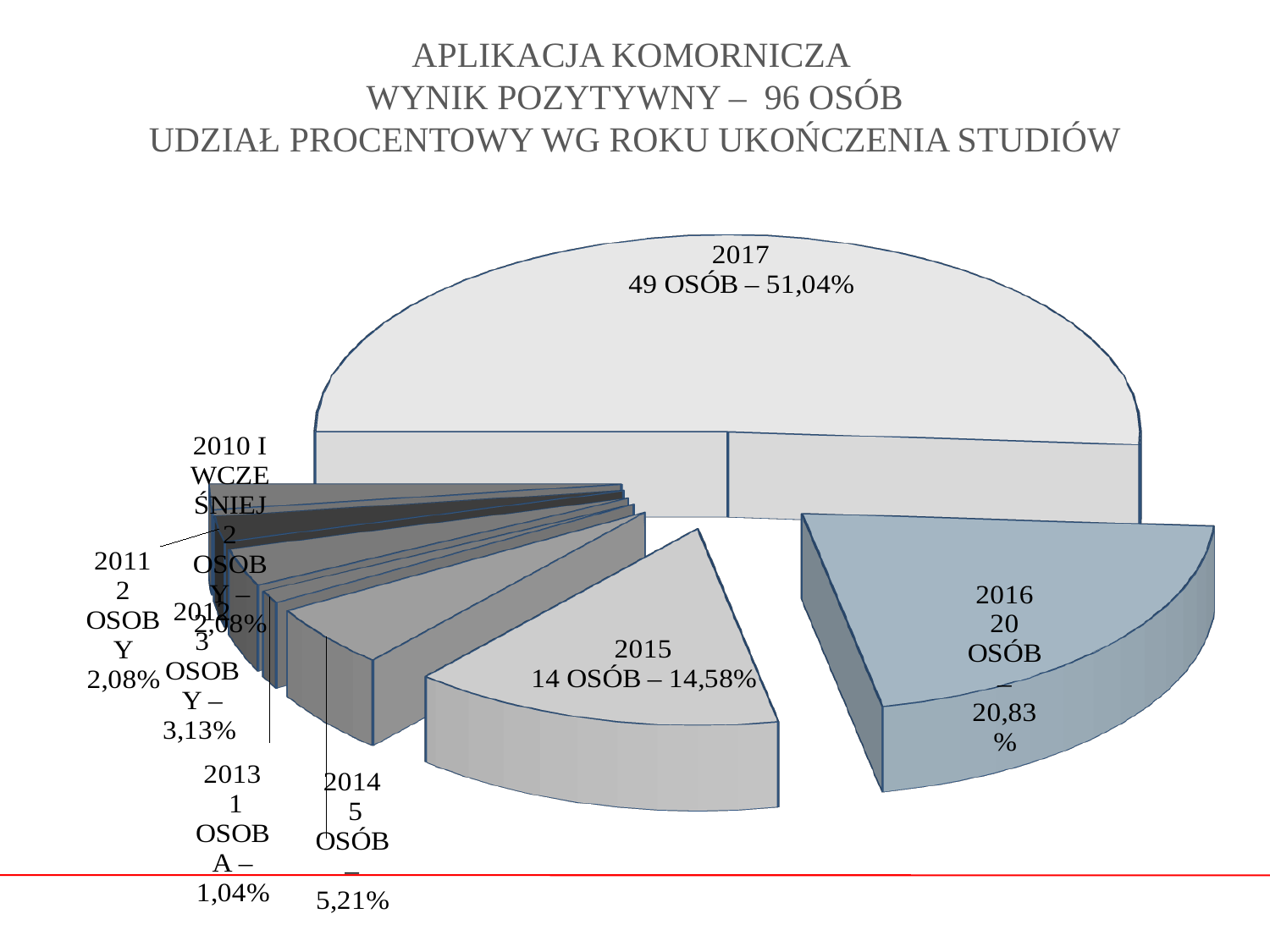
What is the difference in number of people between the 2017 and 2016 slices? 29 What kind of chart is shown on the slide? pie chart What is the total number of people with a positive result stated in the chart title? 96 OSÓB What percentage share does the 2012 slice have? 3,13% How many people are in the 2014 slice? 5 Which year has the smallest slice of the pie? 2013 How many people (osób) are in the 2016 slice? 20 What percentage share does the 2015 slice have? 14,58% Which slice is larger, 2015 or 2014? 2015 What percentage share does the 2017 slice have? 51,04% Which year has the largest slice of the pie? 2017 How many slices does the pie chart have? 8